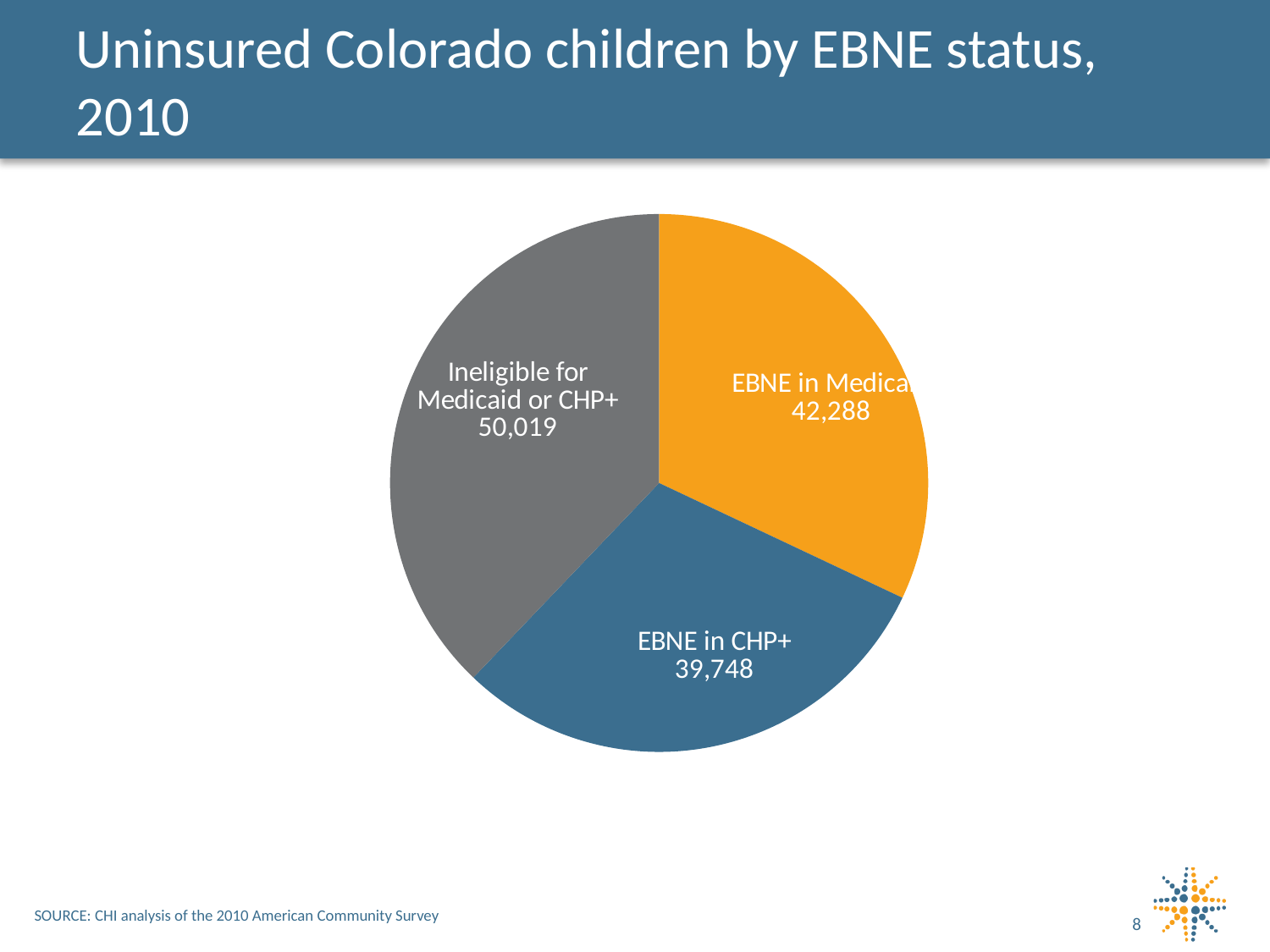
What is the difference between the orange slice's value (42,288) and the EBNE in CHP+ value? 2,540 What is the value for EBNE in CHP+? 39,748 Which category has the smallest slice of the pie? EBNE in CHP+ How many slices does the pie chart have? 3 Which is larger: the value for Ineligible for Medicaid or CHP+ or the value for EBNE in CHP+? Ineligible for Medicaid or CHP+ What is the difference between the Ineligible for Medicaid or CHP+ value and the EBNE in CHP+ value? 10,271 Which category has the largest slice of the pie? Ineligible for Medicaid or CHP+ How many uninsured Colorado children are ineligible for Medicaid or CHP+? 50,019 What value is shown on the orange slice of the pie chart? 42,288 What is the total of the three values shown in the pie chart? 132,055 What colour is the slice for Ineligible for Medicaid or CHP+? Gray What type of chart is shown on the slide? Pie chart